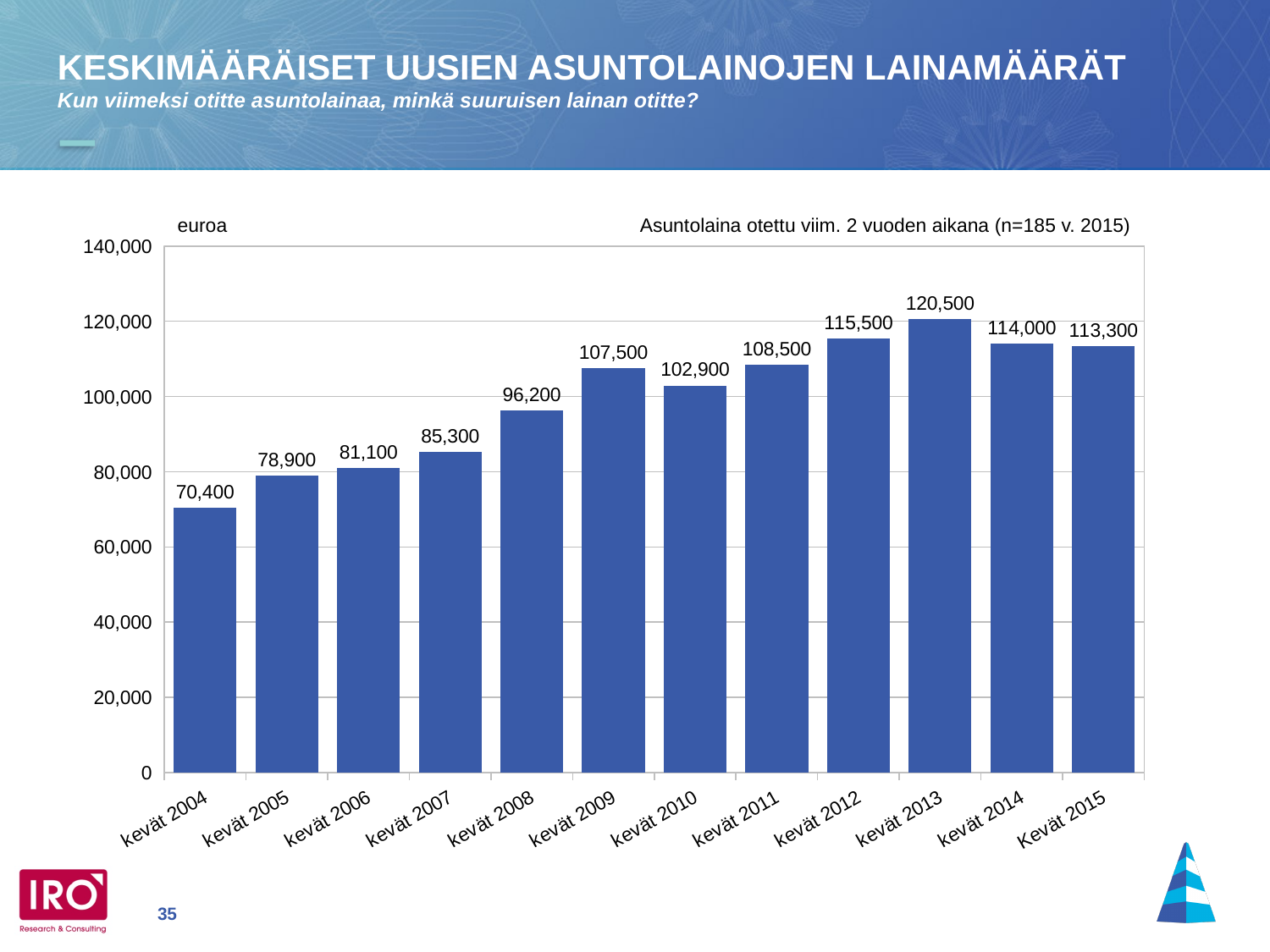
What is the value for Kevät 2015? 113,300 What kind of chart is shown on the slide? bar chart Which is larger, the value for Kevät 2009 or the value for Kevät 2010? Kevät 2009 Is the value for Kevät 2008 greater or less than 100,000? less Which category has the highest value? Kevät 2013 Which category has the lowest value? Kevät 2004 How many categories are shown on the x axis? 12 What unit label is shown at the top of the y axis? euroa What is the value for Kevät 2010? 102,900 What is the value for Kevät 2004? 70,400 What is the difference between the values for Kevät 2014 and Kevät 2015? 700 What is the difference between the values for Kevät 2013 and Kevät 2004? 50,100